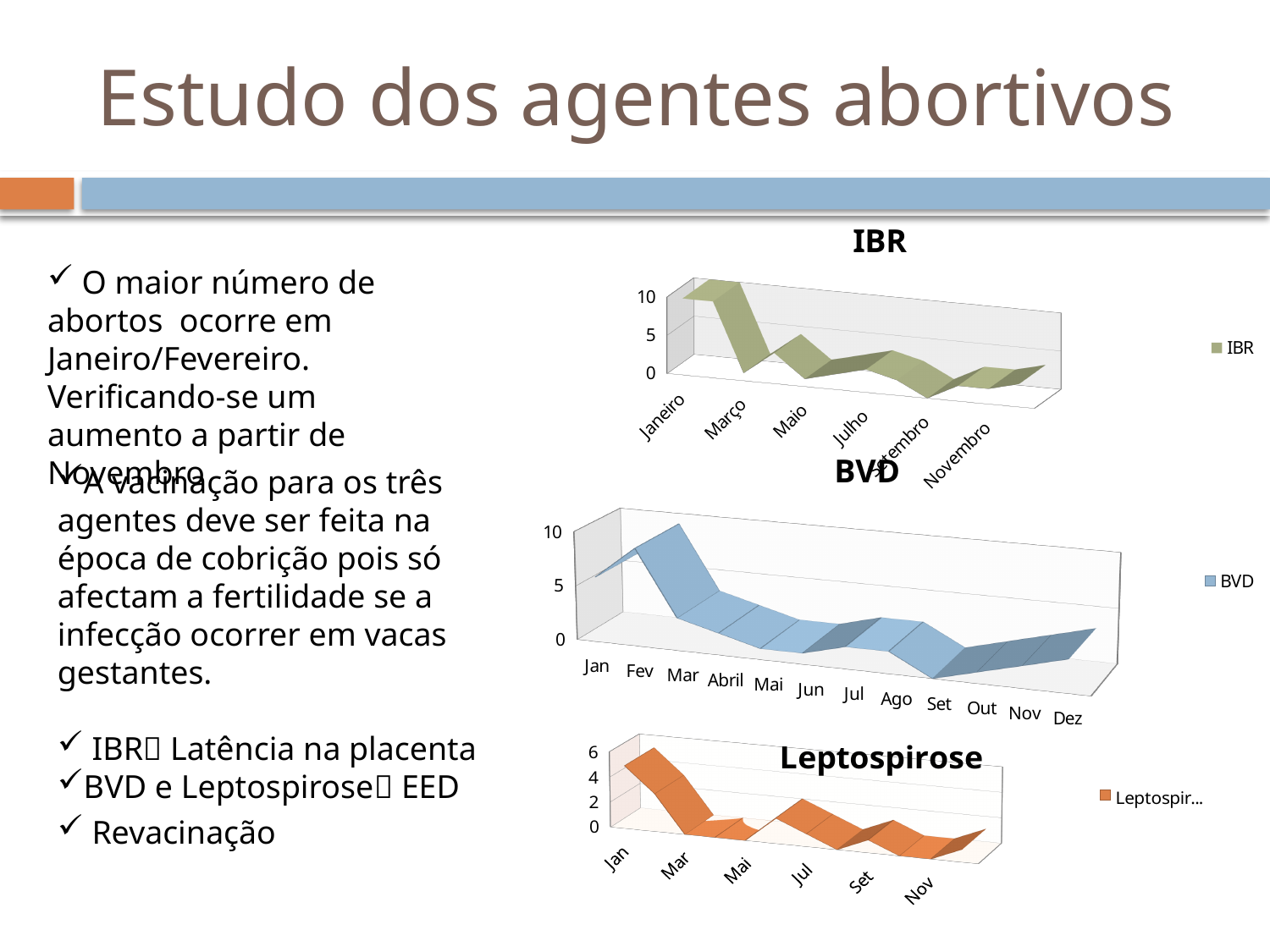
How many series does the legend of the BVD chart list? 1 How many categories are shown on the x axis of the BVD chart? 12 In the BVD chart, which month has the highest value? Fev In the BVD chart, do the values rise or fall from Fev to Jun? fall In the Leptospirose chart, is the value for Jan greater or less than 4? greater In the BVD chart, is the value for Fev greater or less than 5? greater What series name appears in the legend of the top chart? IBR What kind of chart is the IBR chart? 3D line chart In the BVD chart, which is larger, the value for Fev or the value for Jun? Fev In the BVD chart, is the value for Set greater or less than 5? less What is the title of the bottom chart on the slide? Leptospirose